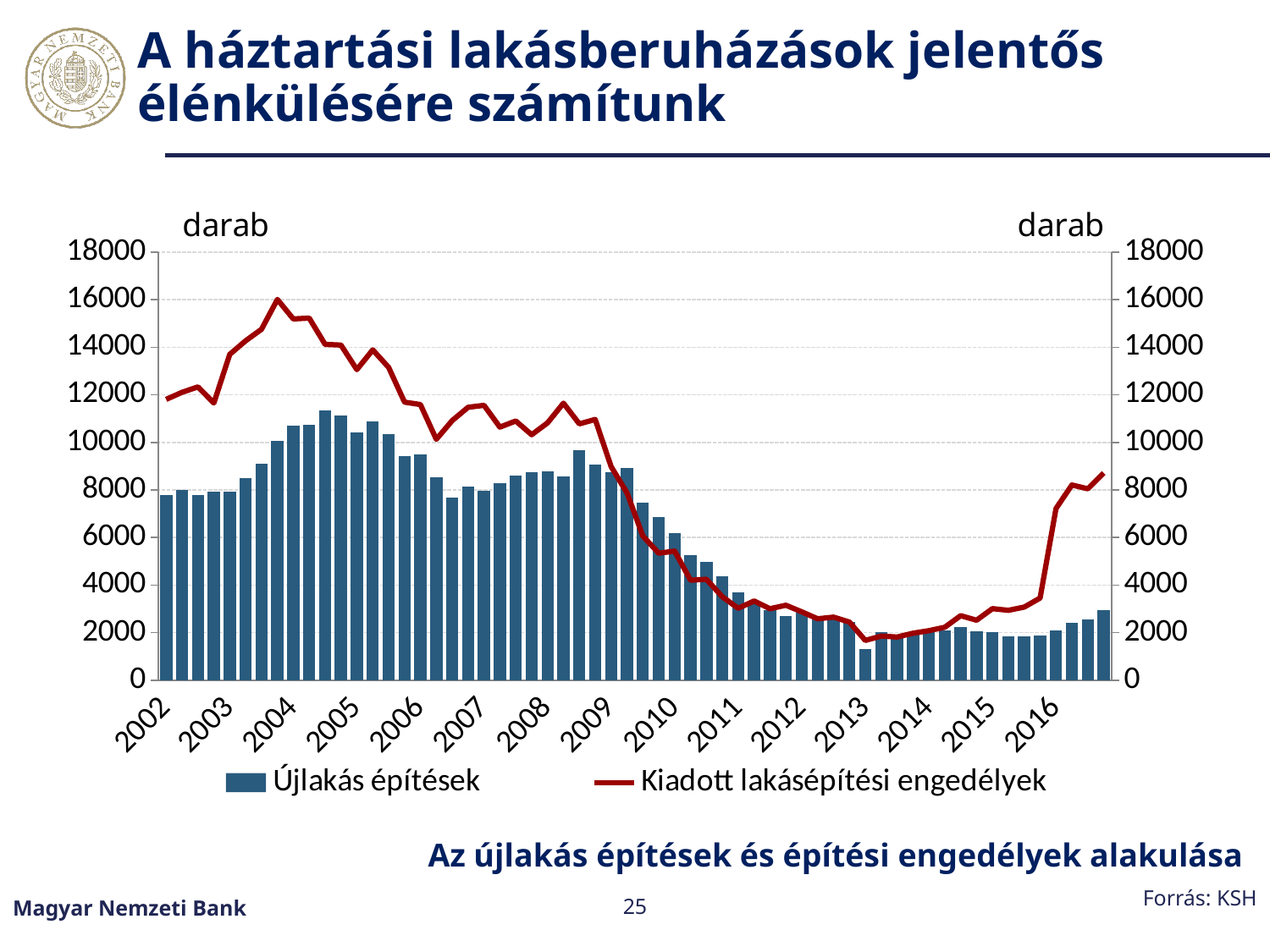
Is the peak value of the Kiadott lakásépítési engedélyek line greater or less than 14000? greater Is the lowest Újlakás építések bar in 2013 greater or less than 2000? less What unit is shown on the vertical axes? darab Does the Kiadott lakásépítési engedélyek line rise or fall between 2004 and 2013? Fall Which series is drawn as bars? Újlakás építések Is the highest Újlakás építések bar in 2005 greater or less than 10000? greater In which year do the Újlakás építések bars reach their lowest value? 2013 In 2004, which series has the higher value: Újlakás építések or Kiadott lakásépítési engedélyek? Kiadott lakásépítési engedélyek How many series does the legend list? 2 What kind of chart is shown on the slide? A combined bar and line chart How many year labels are shown on the x axis? 15